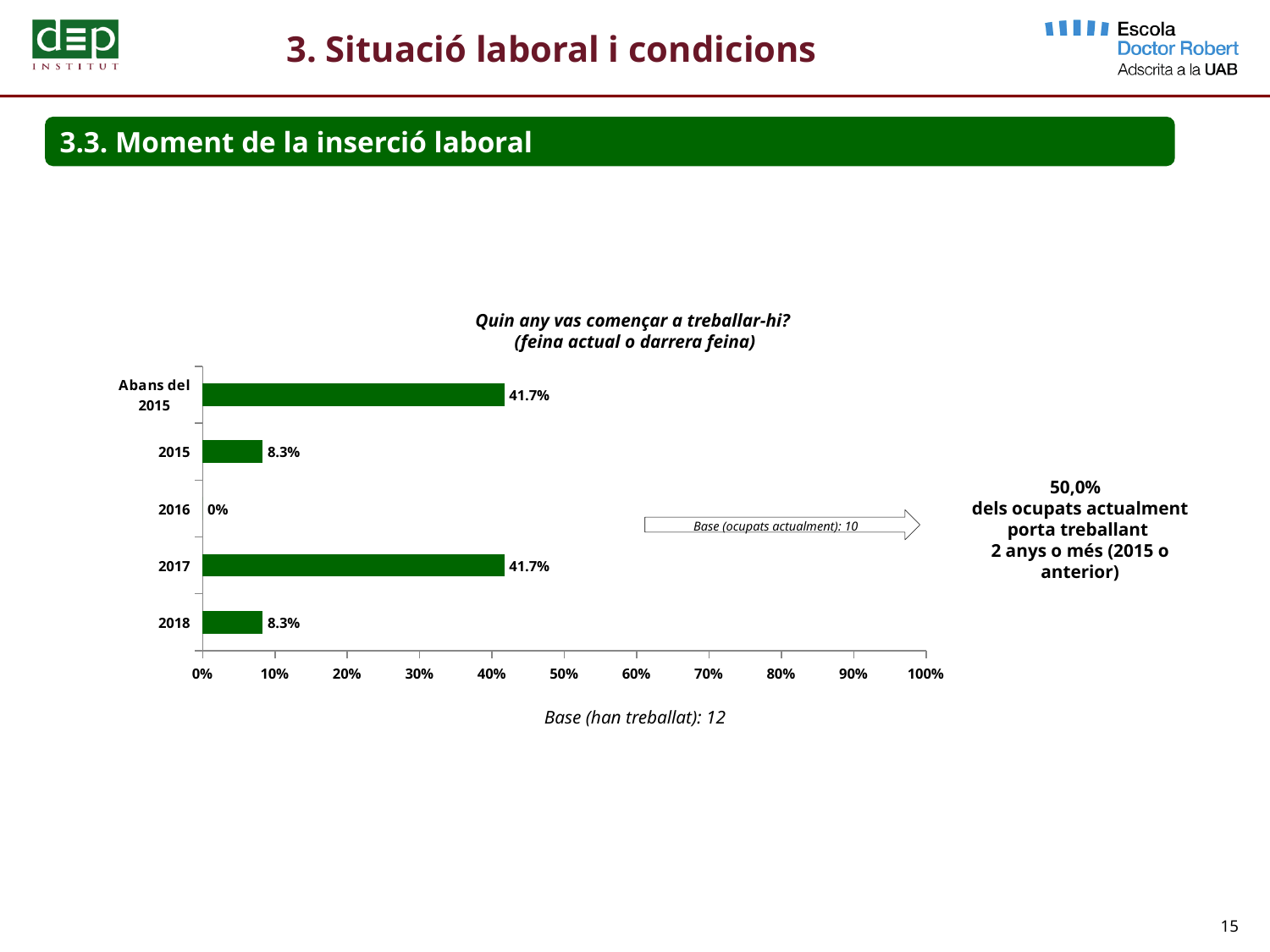
What is the value for 'Abans del 2015'? 41.7% Which is larger, the value for 2015 or the value for 2017? 2017 What is the difference between the values for 2017 and 2018? 33.4% What is the base (number of respondents) stated below the chart? 12 What is the value for 2017? 41.7% What kind of chart is shown on the slide? bar chart What is the value for 2018? 8.3% How many categories are shown on the chart? 5 Is the value for 'Abans del 2015' greater or less than 50%? less Which category has the lowest value? 2016 What is the value for 2015? 8.3% What is the value for 2016? 0%